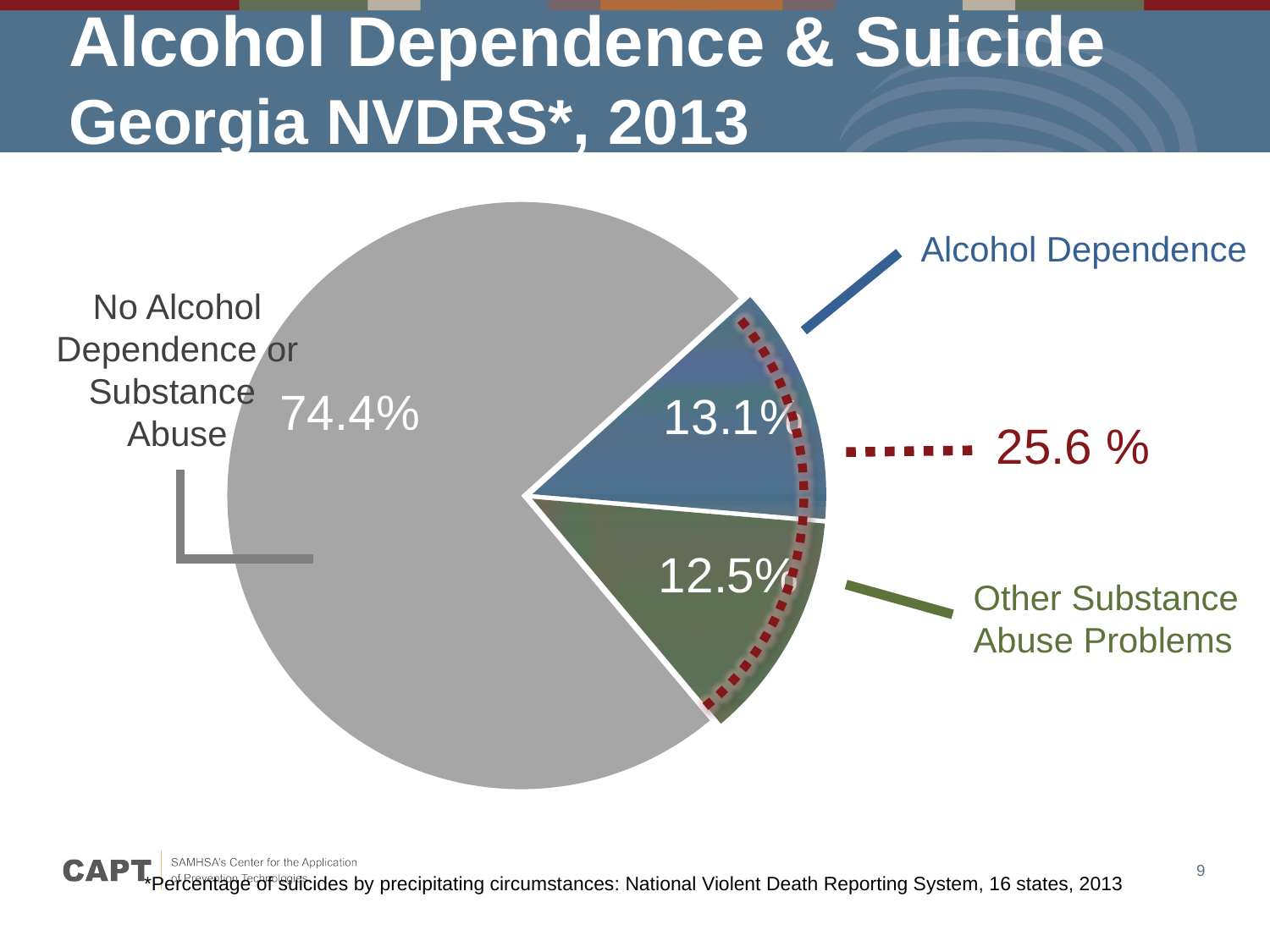
Which slice of the pie is the largest? No Alcohol Dependence or Substance Abuse What is the title of the slide containing the chart? Alcohol Dependence & Suicide Georgia NVDRS*, 2013 Which slice of the pie is the smallest? Other Substance Abuse Problems What percentage is shown for the Alcohol Dependence slice? 13.1% Which is larger, the Alcohol Dependence slice or the Other Substance Abuse Problems slice? Alcohol Dependence What percentage is shown for the No Alcohol Dependence or Substance Abuse slice? 74.4% What kind of chart is shown on the slide? pie chart What percentage is shown for the Other Substance Abuse Problems slice? 12.5% How many slices does the pie chart have? 3 What colour is the No Alcohol Dependence or Substance Abuse slice? gray What combined percentage is labelled for the Alcohol Dependence and Other Substance Abuse Problems slices together? 25.6 % What is the difference between the No Alcohol Dependence or Substance Abuse slice and the Alcohol Dependence slice? 61.3%